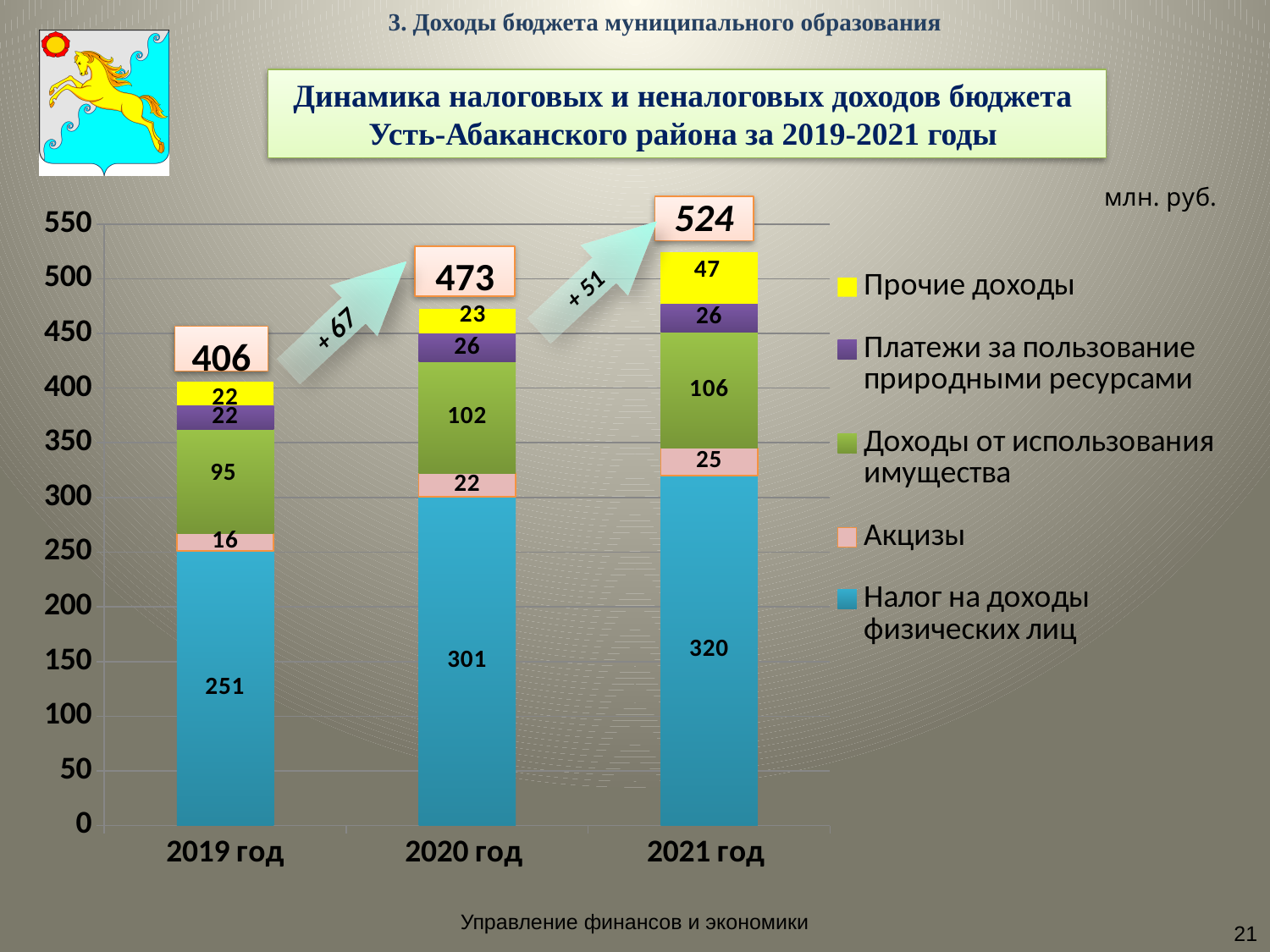
What is the value of Акцизы for 2019 год? 16 What is the value of Доходы от использования имущества for 2021 год? 106 How many series does the legend list? 5 Which is larger: Прочие доходы in 2021 год or Прочие доходы in 2020 год? 2021 год Do the total values rise or fall from 2019 год to 2021 год? Rise What is the difference between the totals for 2020 год and 2019 год? 67 Which year has the lowest total? 2019 год What is the value of Налог на доходы физических лиц for 2020 год? 301 What is the total of the stacked bar for 2021 год? 524 What type of chart is shown on the slide? Stacked bar chart How many years (categories) are shown on the x axis? 3 What unit of measurement is indicated for the chart? млн. руб.